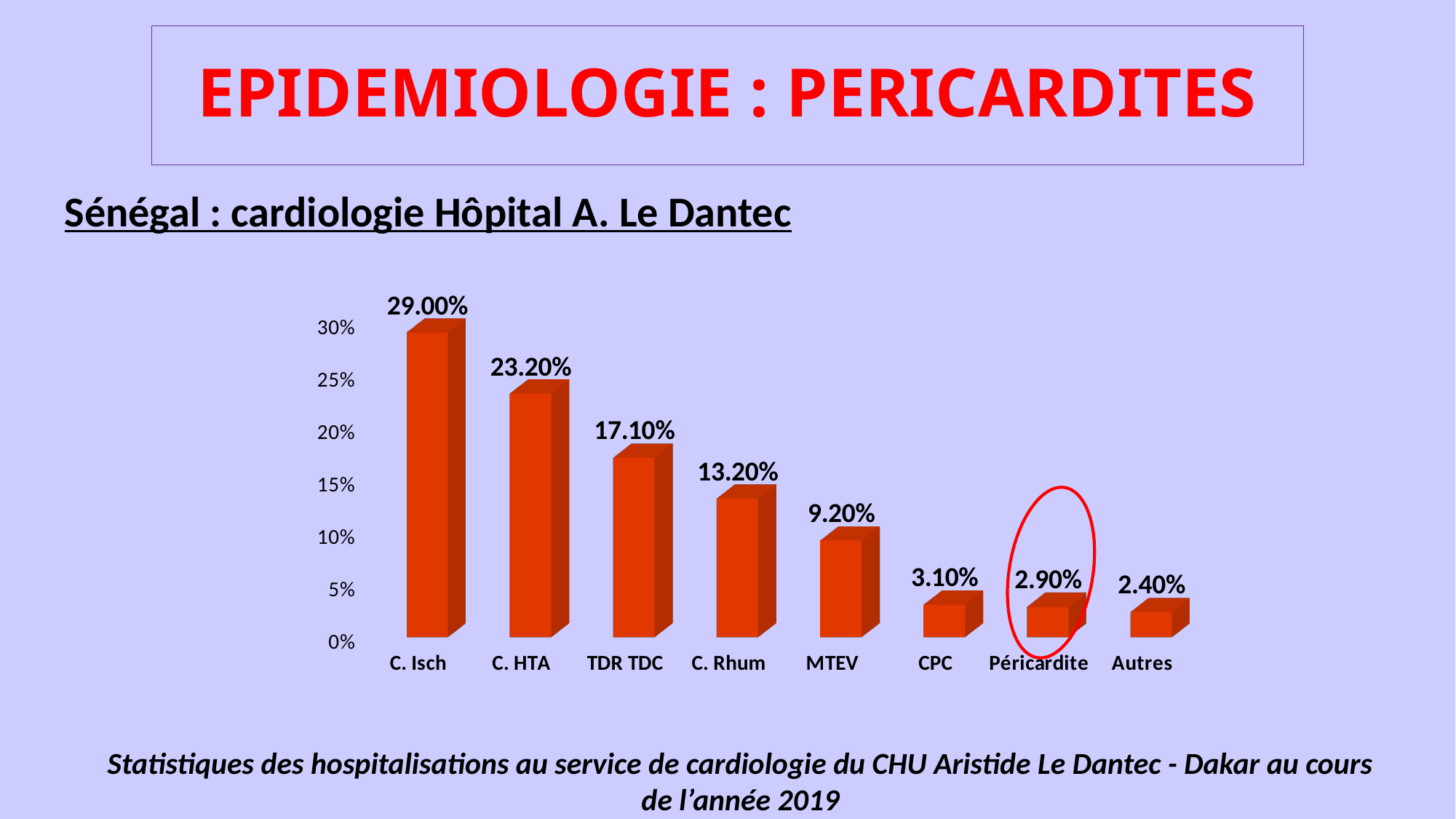
Do the values rise or fall from left to right along the x axis? fall What kind of chart is shown on the slide? bar chart What is the value for C. HTA? 23.20% How many categories are shown on the x axis? 8 What is the difference between the values for C. Isch and C. HTA? 5.80% What is the value for MTEV? 9.20% Which category has the lowest value? Autres What is the difference between the values for CPC and Péricardite? 0.20% Which category has the highest value? C. Isch Which is larger, the value for TDR TDC or the value for C. Rhum? TDR TDC Which bar is circled in red on the chart? Péricardite What is the value for Péricardite? 2.90%